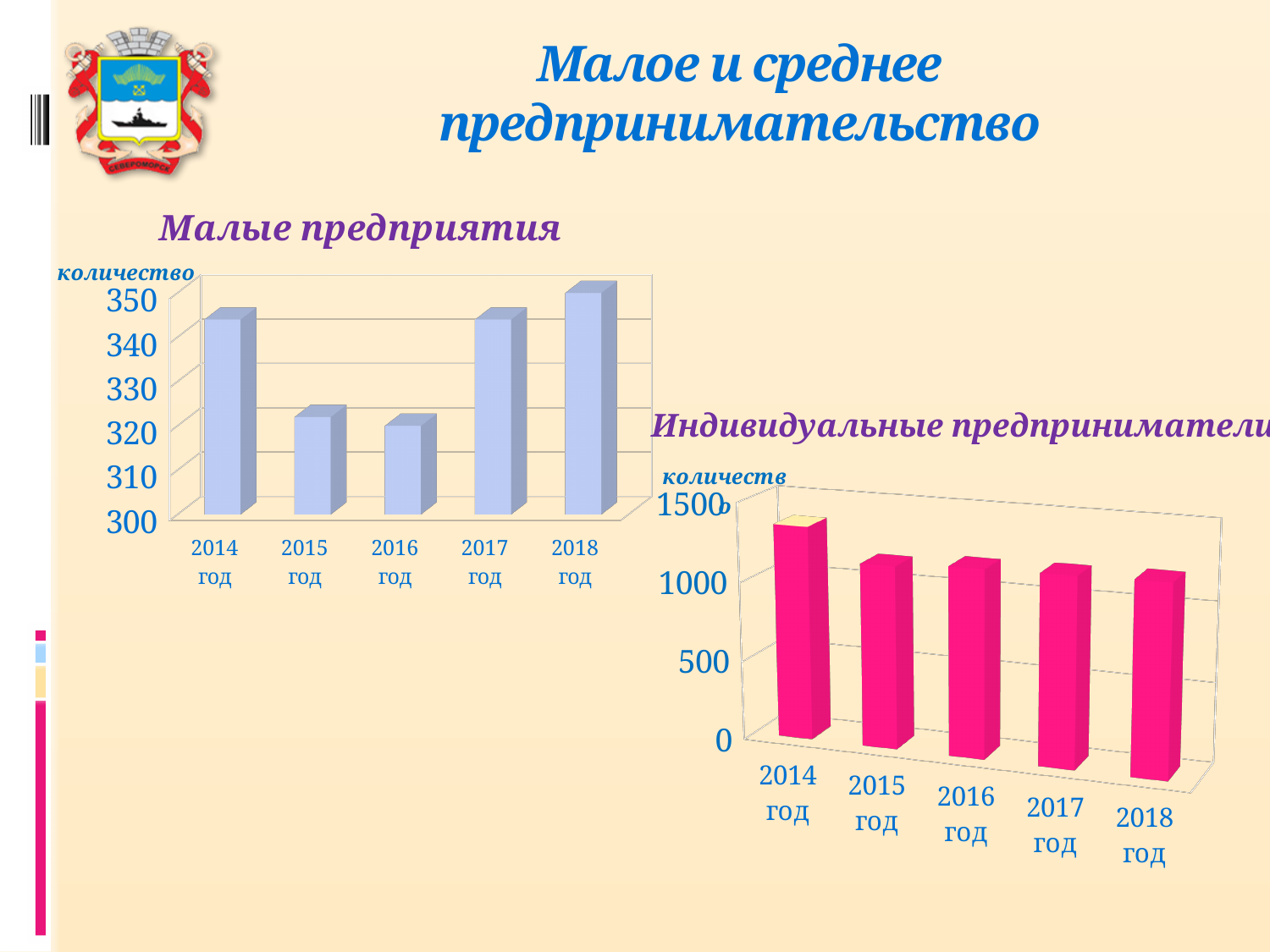
On the "Малые предприятия" chart, is the value for 2018 год greater or less than 340? greater How many bars are on the "Индивидуальные предприниматели" chart? 5 How many years are shown on the "Малые предприятия" chart? 5 On the "Малые предприятия" chart, which is larger, the value for 2016 год or the value for 2017 год? 2017 год What kind of chart is the "Индивидуальные предприниматели" chart? bar chart On the "Индивидуальные предприниматели" chart, is the value for 2014 год greater or less than 1000? greater What kind of chart is the "Малые предприятия" chart? bar chart On the "Малые предприятия" chart, which year has the highest value? 2018 год On the "Малые предприятия" chart, is the value for 2015 год greater or less than 330? less On the "Индивидуальные предприниматели" chart, which year has the highest value? 2014 год On the "Индивидуальные предприниматели" chart, do the values generally rise or fall from 2014 to 2018? fall What is the label on the vertical axis of the "Малые предприятия" chart? количество